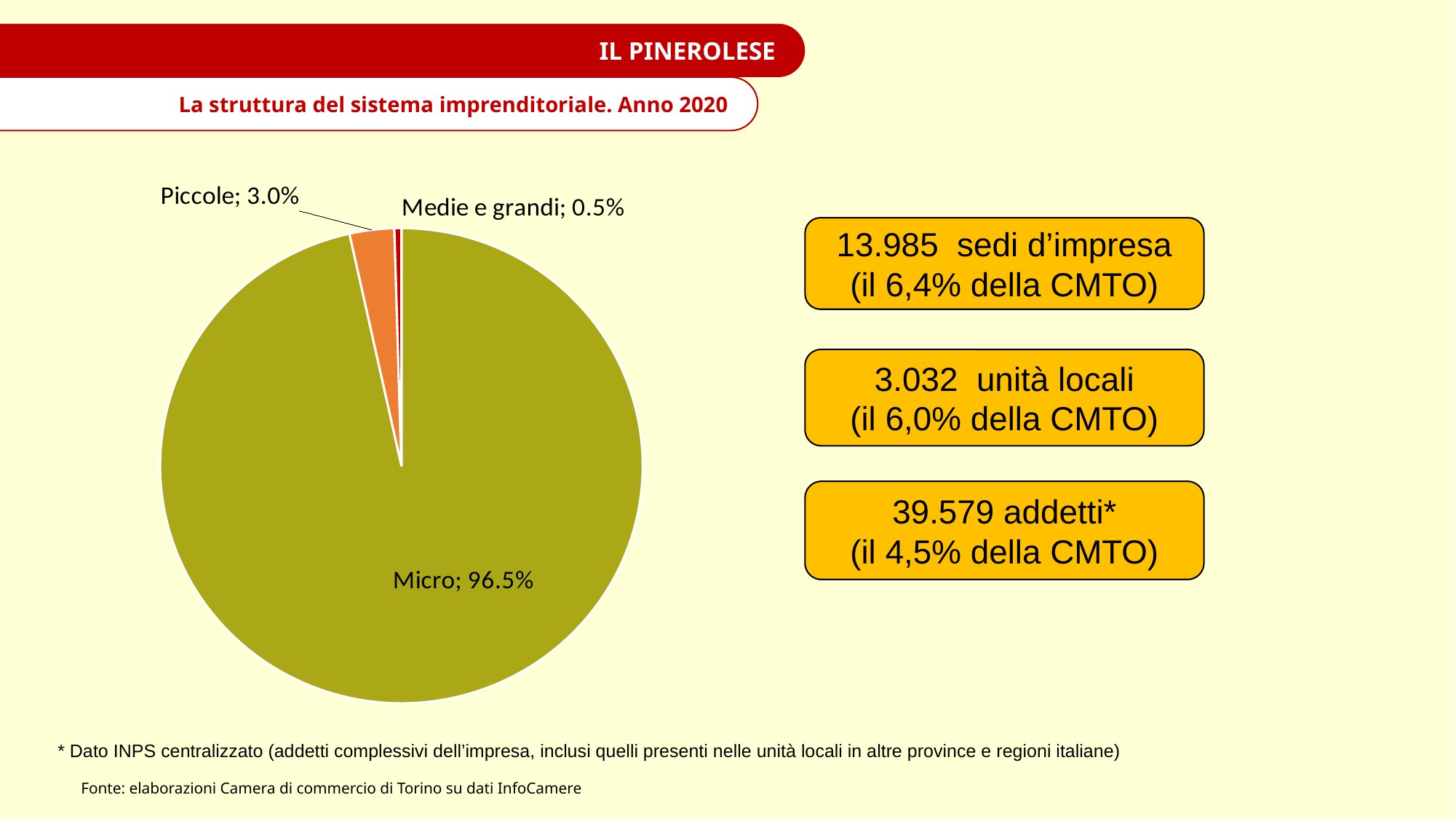
Which category has the smallest slice of the pie? Medie e grandi What is the difference in percentage points between the Micro and Piccole slices? 93.5 What share of the pie does the Piccole slice represent? 3.0% How many slices does the pie chart have? 3 Which slice is larger, Piccole or Medie e grandi? Piccole What colour is the Piccole slice of the pie? orange What share of the pie does the Micro slice represent? 96.5% What is the difference in percentage points between the Piccole and Medie e grandi slices? 2.5 What share of the pie does the Medie e grandi slice represent? 0.5% What colour is the Micro slice of the pie? olive green Which category has the largest slice of the pie? Micro What kind of chart is shown on the slide? pie chart